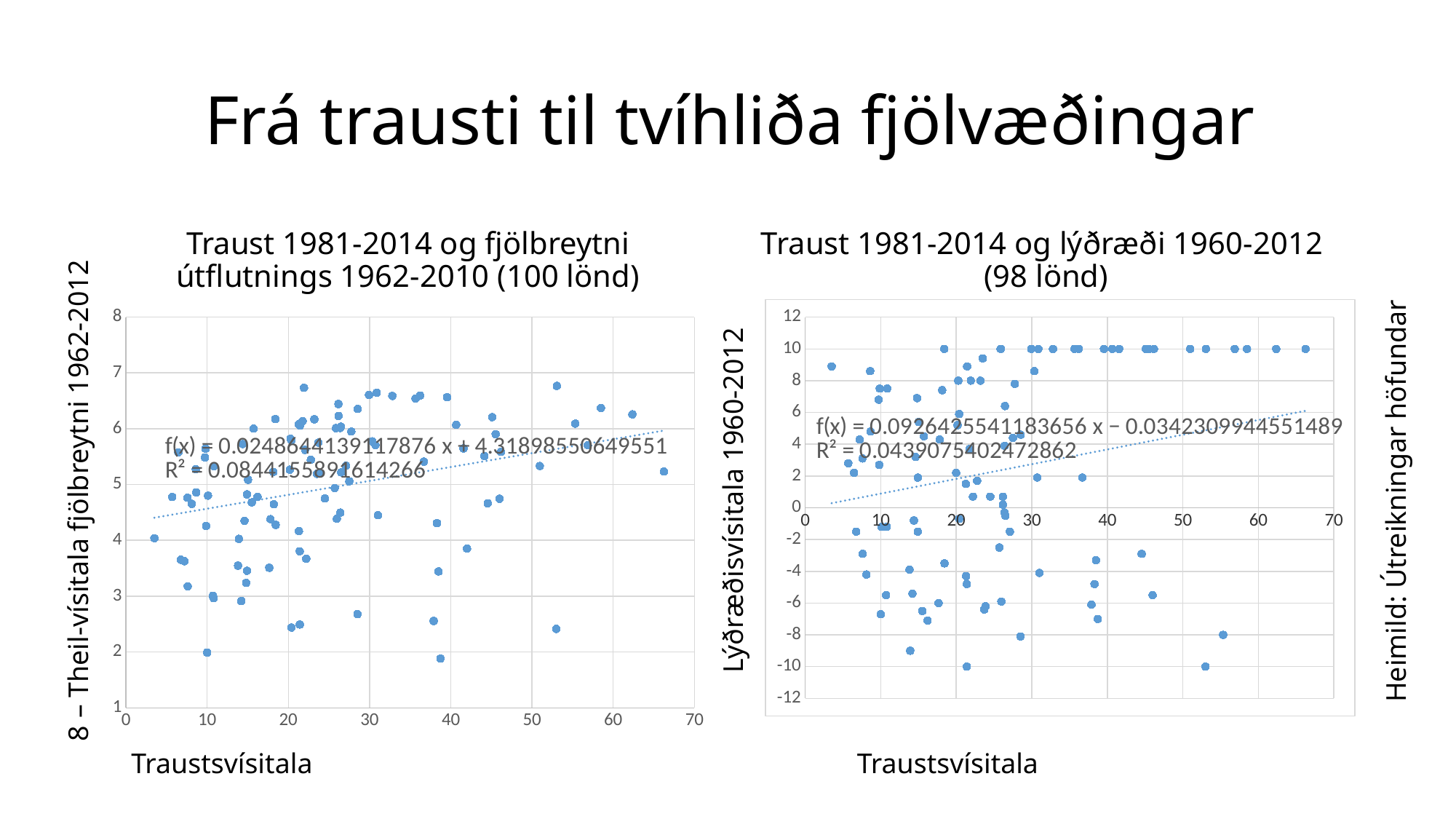
In the right chart, does the fitted trend line rise or fall as Traustsvísitala increases? Rises What R² value is printed on the left chart, 'Traust 1981-2014 og fjölbreytni útflutnings 1962-2010'? 0.0844155891614266 According to its title, how many countries are plotted in the left chart, 'Traust 1981-2014 og fjölbreytni útflutnings 1962-2010'? 100 What kind of chart is the right chart, 'Traust 1981-2014 og lýðræði 1960-2012'? Scatter chart What kind of chart is the left chart, 'Traust 1981-2014 og fjölbreytni útflutnings 1962-2010'? Scatter chart According to its title, how many countries are plotted in the right chart, 'Traust 1981-2014 og lýðræði 1960-2012'? 98 In the right chart, is the highest Lýðræðisvísitala value plotted greater or less than 8? greater In the left chart, does the fitted trend line rise or fall as Traustsvísitala increases? Rises In the right chart, is the lowest Lýðræðisvísitala value plotted greater or less than -8? less What is the x-axis label of the left chart? Traustsvísitala What R² value is printed on the right chart, 'Traust 1981-2014 og lýðræði 1960-2012'? 0.0439075402472862 What is the y-axis label of the right chart? Lýðræðisvísitala 1960-2012